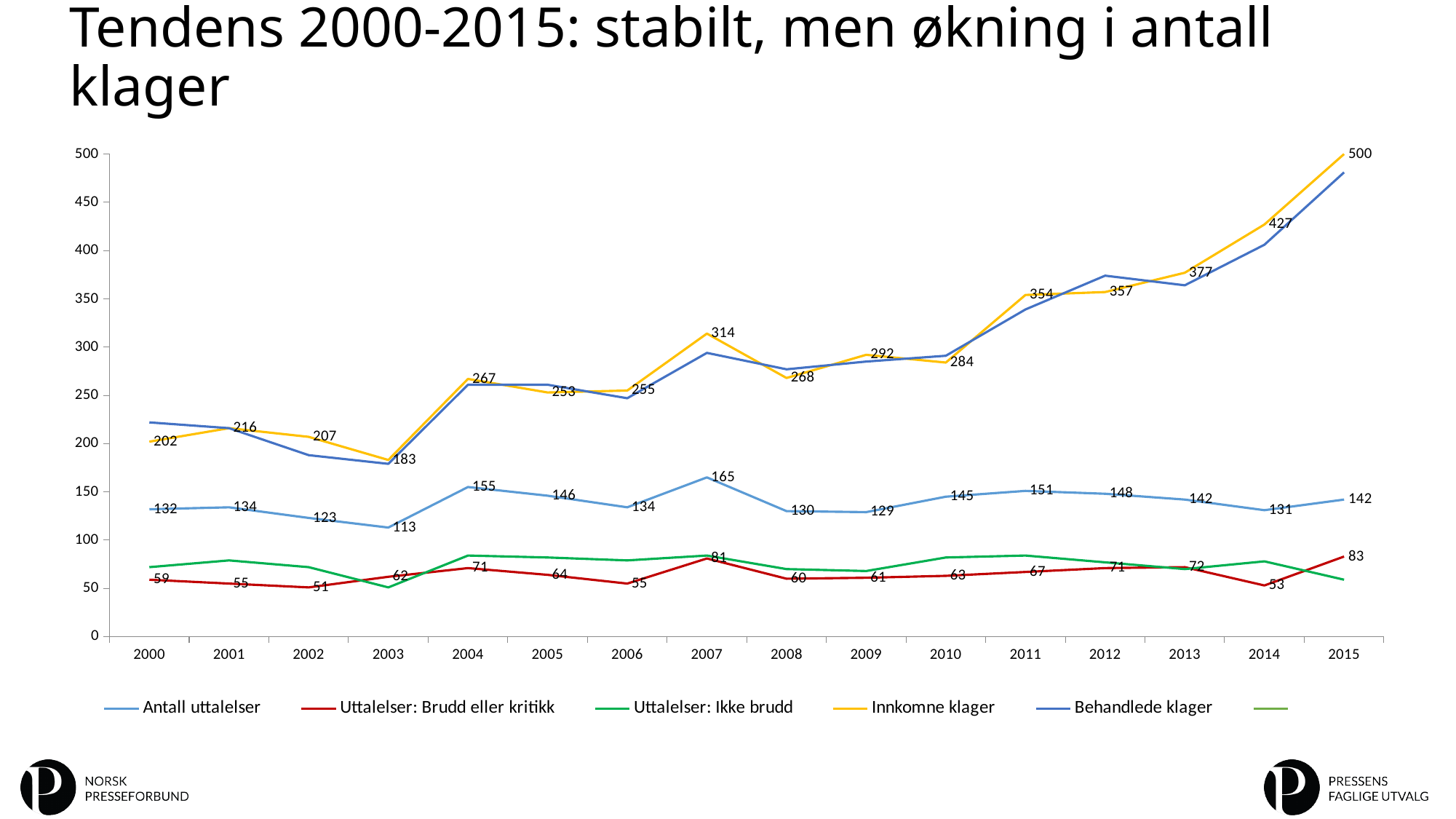
What is the difference between Innkomne klager in 2015 and in 2000? 298 In which year is Uttalelser: Brudd eller kritikk highest? 2015 What kind of chart is shown on the slide? line chart What is the value of Antall uttalelser in 2007? 165 In which year is Antall uttalelser lowest? 2003 How many years are shown on the x axis? 16 In which year is Innkomne klager highest? 2015 Is the value for Behandlede klager in 2015 greater or less than 450? greater What is the value of Uttalelser: Brudd eller kritikk in 2014? 53 Which year has the larger value for Antall uttalelser, 2004 or 2010? 2004 What is the value of Innkomne klager in 2015? 500 In which year is Innkomne klager lowest? 2003